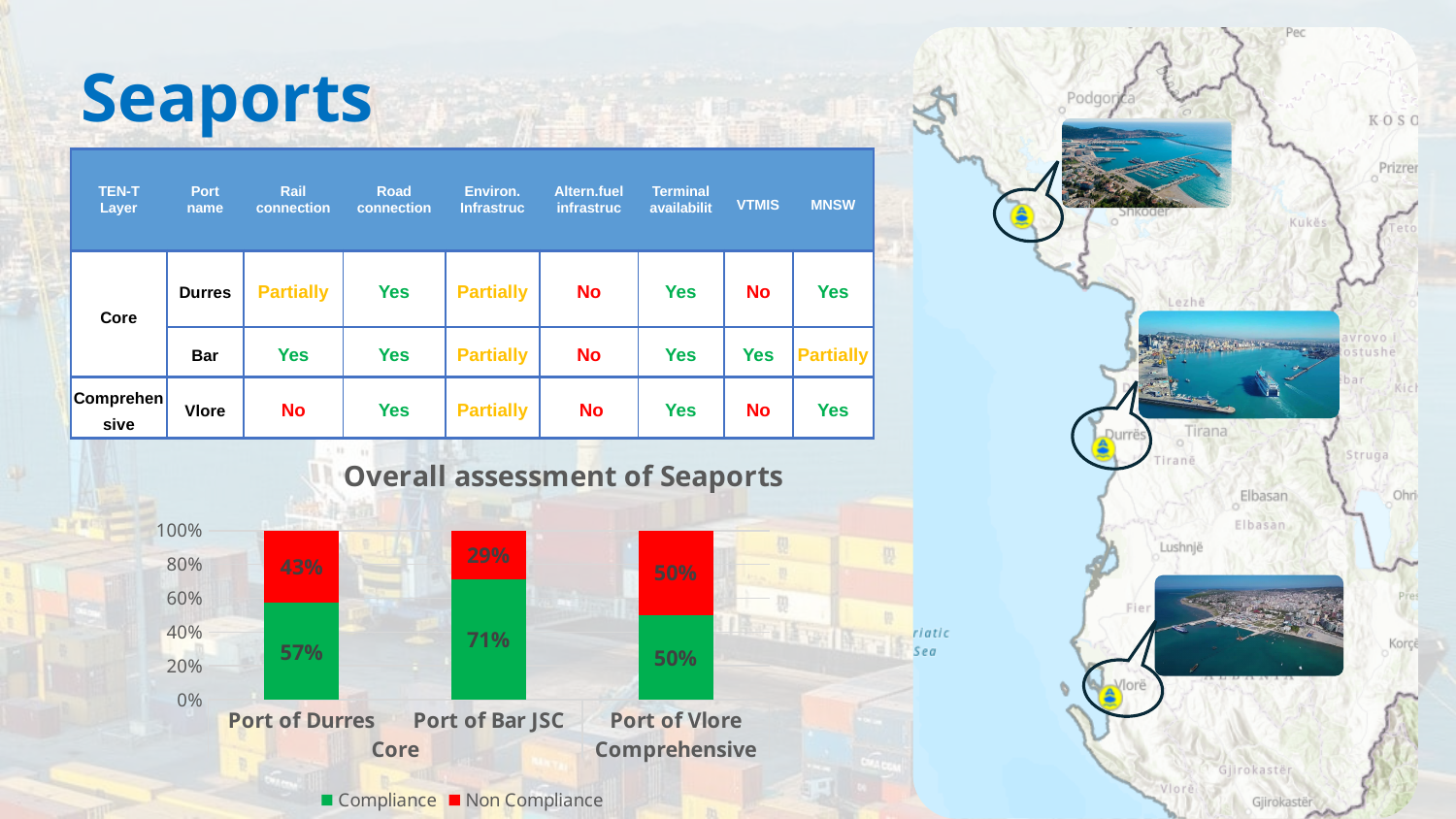
What is the difference between the Compliance values of Port of Bar JSC and Port of Durres in the Overall assessment of Seaports chart? 14% What is the total of the stacked bar for Port of Vlore in the Overall assessment of Seaports chart? 100% Which port has the lowest Compliance value in the Overall assessment of Seaports chart? Port of Vlore Which colour represents Non Compliance in the Overall assessment of Seaports chart? Red What is the Compliance value for Port of Durres in the Overall assessment of Seaports chart? 57% In the Overall assessment of Seaports chart, is the Non Compliance value larger for Port of Durres or Port of Bar JSC? Port of Durres What is the Non Compliance value for Port of Bar JSC in the Overall assessment of Seaports chart? 29% What kind of chart is the Overall assessment of Seaports? Stacked bar chart What is the Compliance value for Port of Vlore in the Overall assessment of Seaports chart? 50% Which port has the highest Compliance value in the Overall assessment of Seaports chart? Port of Bar JSC How many ports are shown in the Overall assessment of Seaports chart? 3 How many series does the legend of the Overall assessment of Seaports chart list? 2